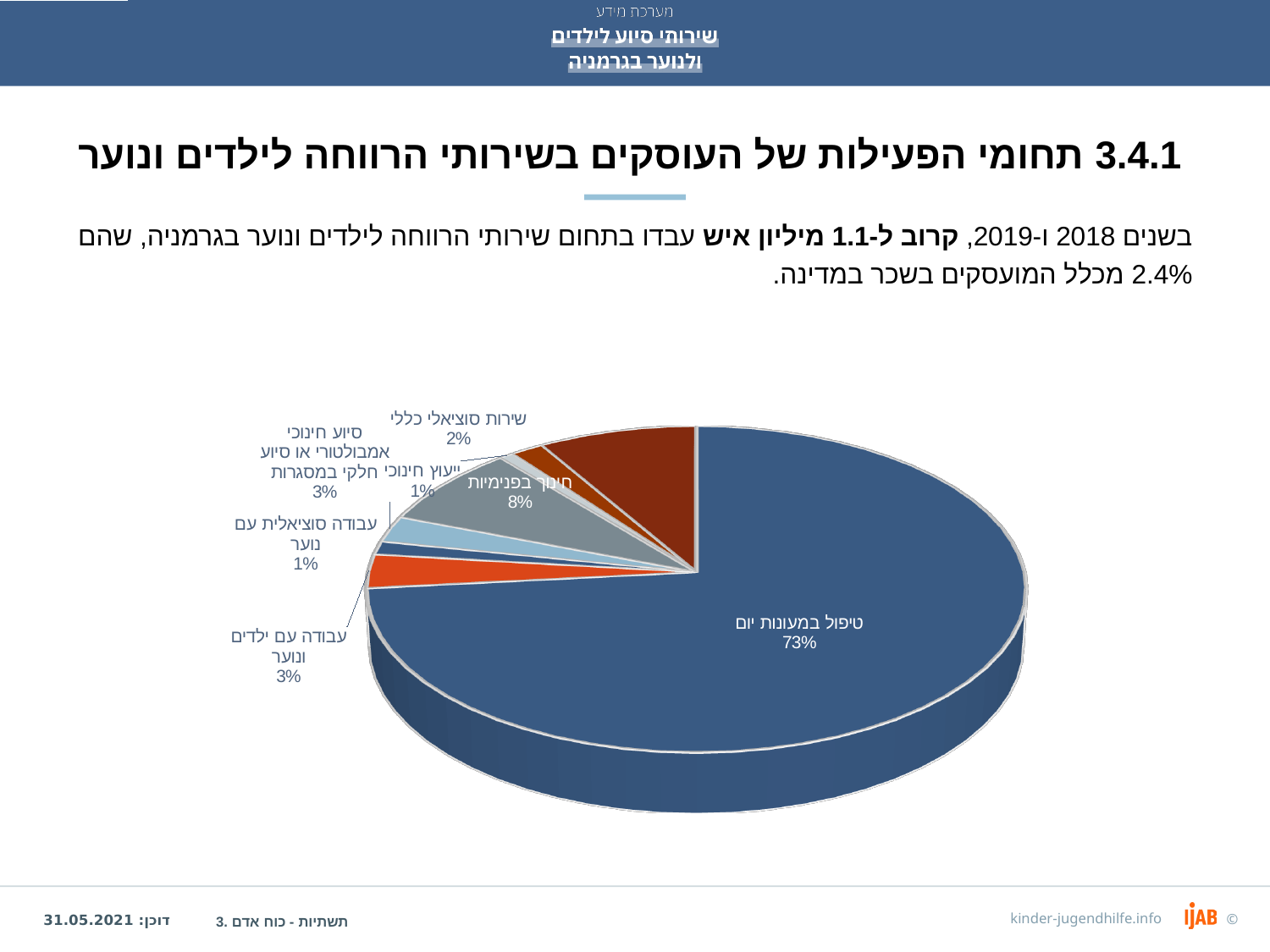
What percentage is shown for חינוך בפנימיות? 8% What kind of chart is shown on the slide? pie chart What is the smallest percentage labelled on the pie chart? 1% What percentage is shown for שירות סוציאלי כללי? 2% What percentage is shown for עבודה סוציאלית עם נוער? 1% What is the difference in percentage points between טיפול במעונות יום and חינוך בפנימיות? 65 Which category has the largest share of the pie? טיפול במעונות יום Is the share for טיפול במעונות יום greater or less than 50%? greater Which is larger: the share for חינוך בפנימיות or the share for עבודה עם ילדים ונוער? חינוך בפנימיות What percentage of the pie is labelled for טיפול במעונות יום? 73% How many labelled categories are shown on the pie chart? 7 What percentage is shown for עבודה עם ילדים ונוער? 3%